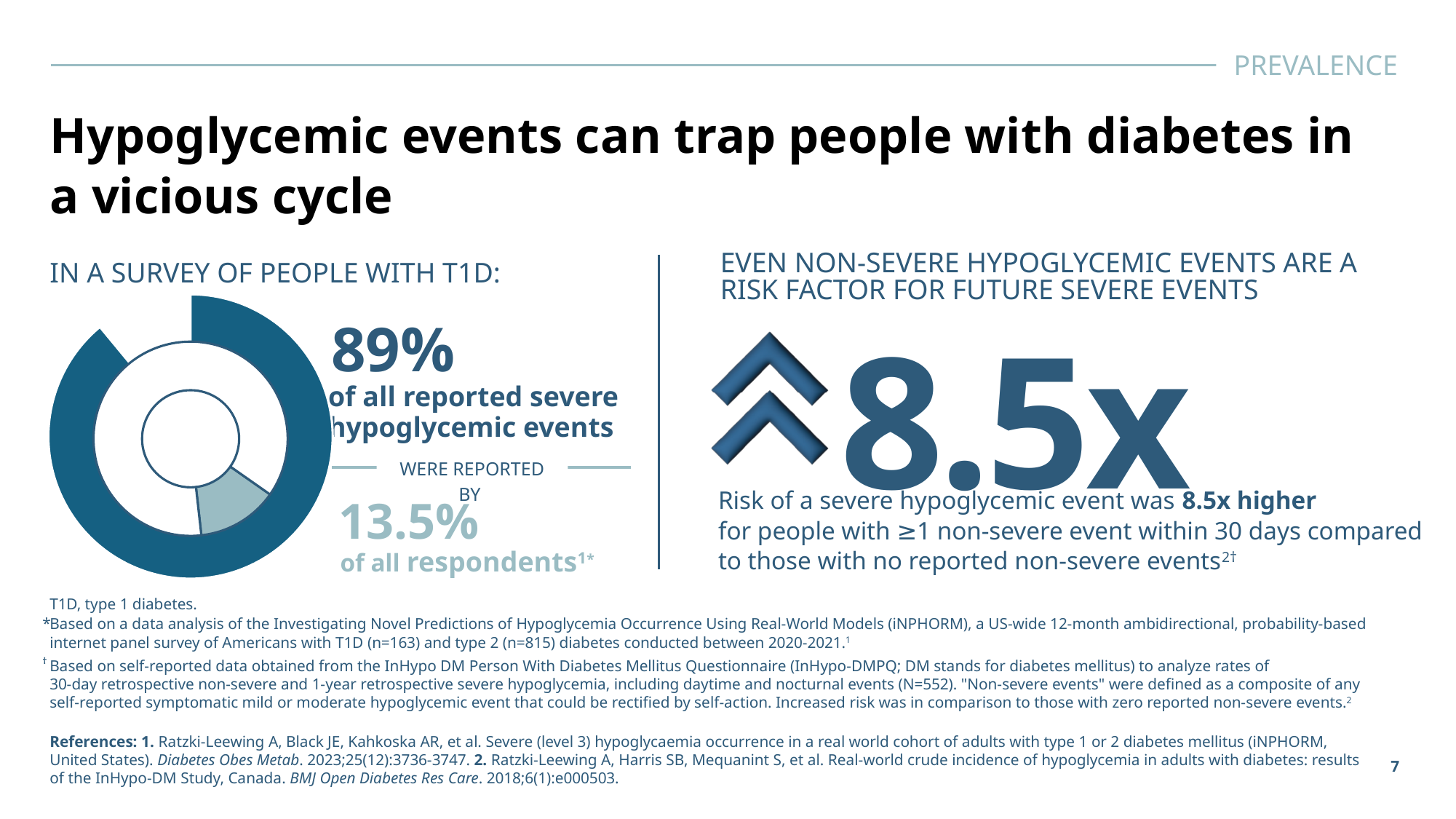
In the donut chart on the left, what percentage of all respondents reported the severe hypoglycemic events? 13.5% How many percentage values are displayed in the donut chart on the left? 2 In the donut chart on the left, which value is larger: the share of severe hypoglycemic events or the share of respondents? The share of severe hypoglycemic events (89%) In the donut chart on the left, does the dark blue segment represent more or less than half of the outer ring? More What heading appears above the donut chart on the left? IN A SURVEY OF PEOPLE WITH T1D: What kind of chart is shown on the left side of the slide? Donut (pie) chart In the donut chart on the left, what percentage of all reported severe hypoglycemic events is shown by the dark blue ring? 89% In the donut chart on the left, what is the difference in percentage points between the share of severe events (89%) and the share of respondents (13.5%)? 75.5 percentage points In the donut chart on the left, what colour is the segment representing 13.5% of respondents? Light blue In the donut chart on the left, what share of the outer ring does the dark blue segment represent? 89%